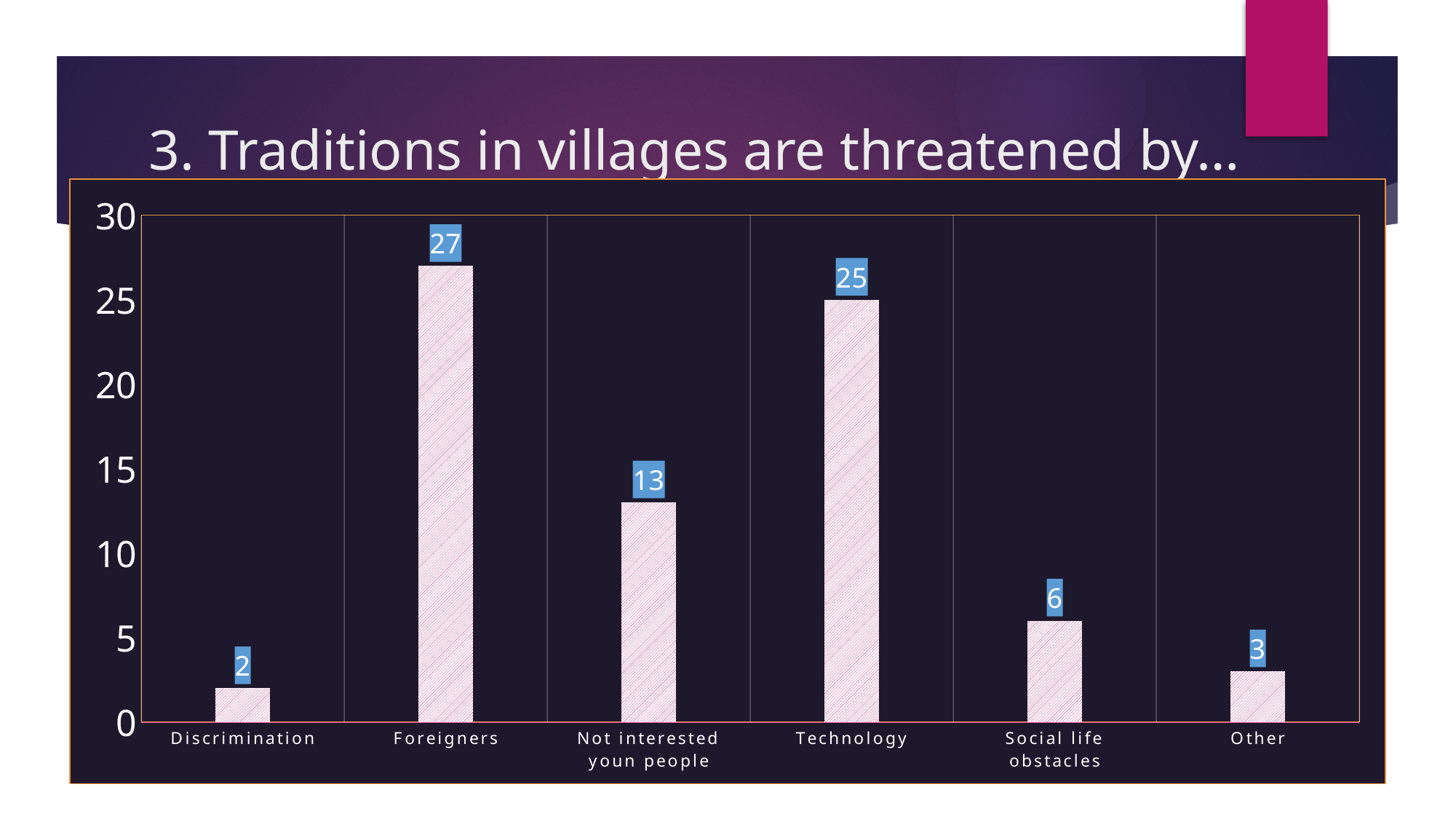
What is the value for Discrimination? 2 What kind of chart is shown on the slide? bar chart What is the value for Social life obstacles? 6 Which is larger, the value for Social life obstacles or the value for Other? Social life obstacles Which category has the highest value? Foreigners Which category has the lowest value? Discrimination How many categories are shown on the x axis? 6 What is the title of the slide? 3. Traditions in villages are threatened by... What is the difference between the values for Not interested youn people and Other? 10 What is the value for Foreigners? 27 What is the difference between the values for Foreigners and Technology? 2 What is the value for Technology? 25